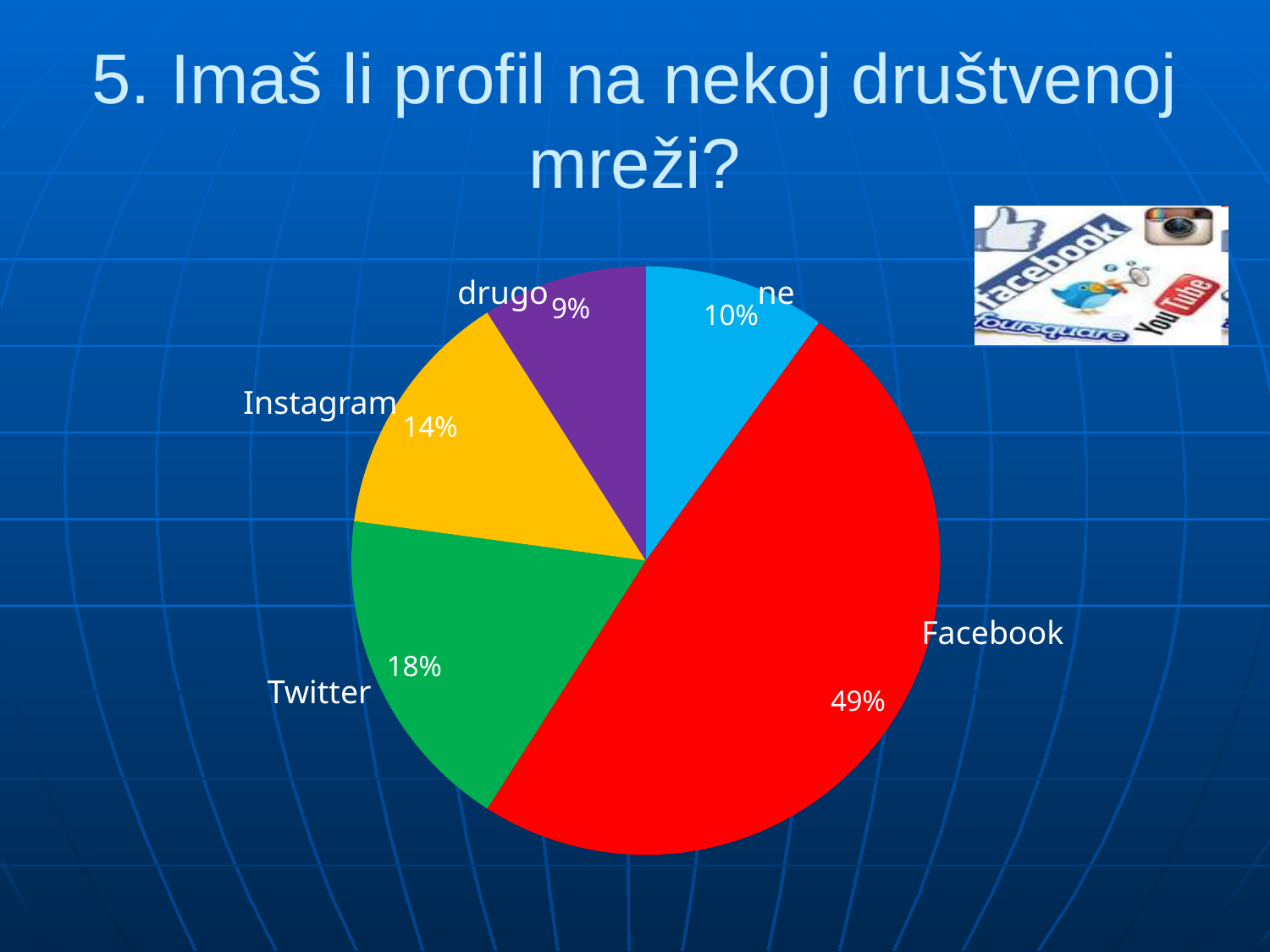
What is the value for Instagram? 14% What kind of chart is shown on the slide? pie chart What share of the pie does Facebook have? 49% What is the value for Twitter? 18% What is the difference between the Facebook and Twitter shares? 31% Which is larger, Instagram or Twitter? Twitter What is the value for 'drugo'? 9% Which category has the largest slice? Facebook What is the value for the 'ne' slice? 10% Which category has the smallest slice? drugo How many slices does the pie chart have? 5 What colour is the Facebook slice? red